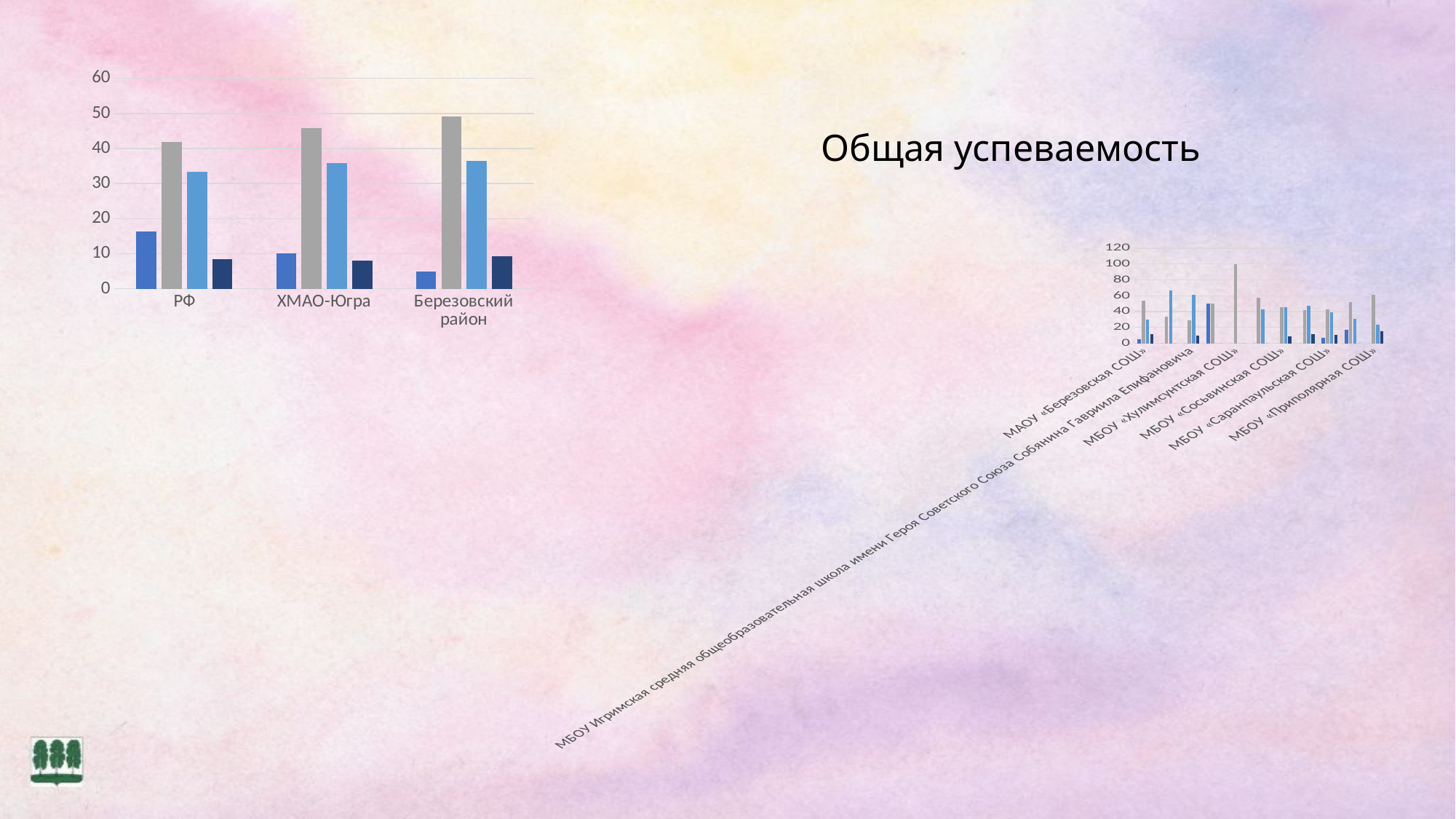
How many bars are plotted for each category in the left chart? 4 What is the highest value shown on the vertical axis of the right chart? 120 In the left chart, is the gray bar larger for РФ or for Березовский район? Березовский район What kind of chart is the chart on the left of the slide? bar chart What is the title shown on the slide above the right chart? Общая успеваемость In the left chart, is the first (dark blue) bar for Березовский район greater or less than 10? less In the left chart, do the first (dark blue) bars rise or fall from РФ to Березовский район? fall In the left chart, which category has the tallest gray bar? Березовский район How many categories are shown on the x axis of the left chart? 3 In the left chart, which category has the tallest first (dark blue) bar? РФ In the left chart, is the gray bar for Березовский район greater or less than 40? greater In the left chart, is the first (dark blue) bar for РФ greater or less than 10? greater